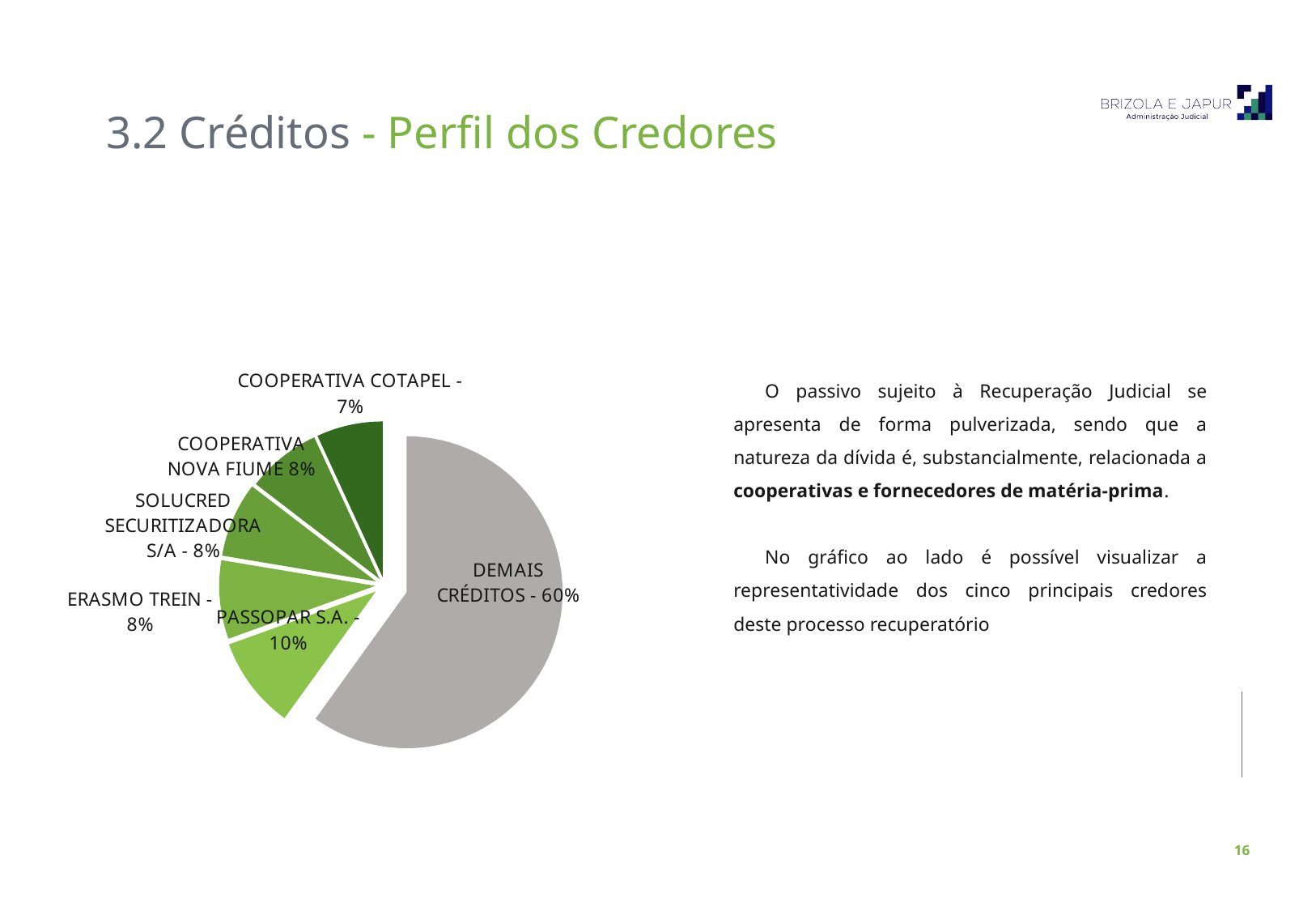
What colour is the DEMAIS CRÉDITOS slice? Grey What share of the pie does DEMAIS CRÉDITOS represent? 60% What is the value shown for ERASMO TREIN? 8% What is the value shown for COOPERATIVA COTAPEL? 7% Which is larger, the share of PASSOPAR S.A. or the share of COOPERATIVA COTAPEL? PASSOPAR S.A. Which slice of the pie is the smallest? COOPERATIVA COTAPEL Which slice of the pie is the largest? DEMAIS CRÉDITOS What is the value shown for SOLUCRED SECURITIZADORA S/A? 8% What is the difference between the share of DEMAIS CRÉDITOS and the share of PASSOPAR S.A.? 50% How many slices does the pie chart have? 6 What kind of chart is shown on the slide? Pie chart What is the value shown for PASSOPAR S.A.? 10%